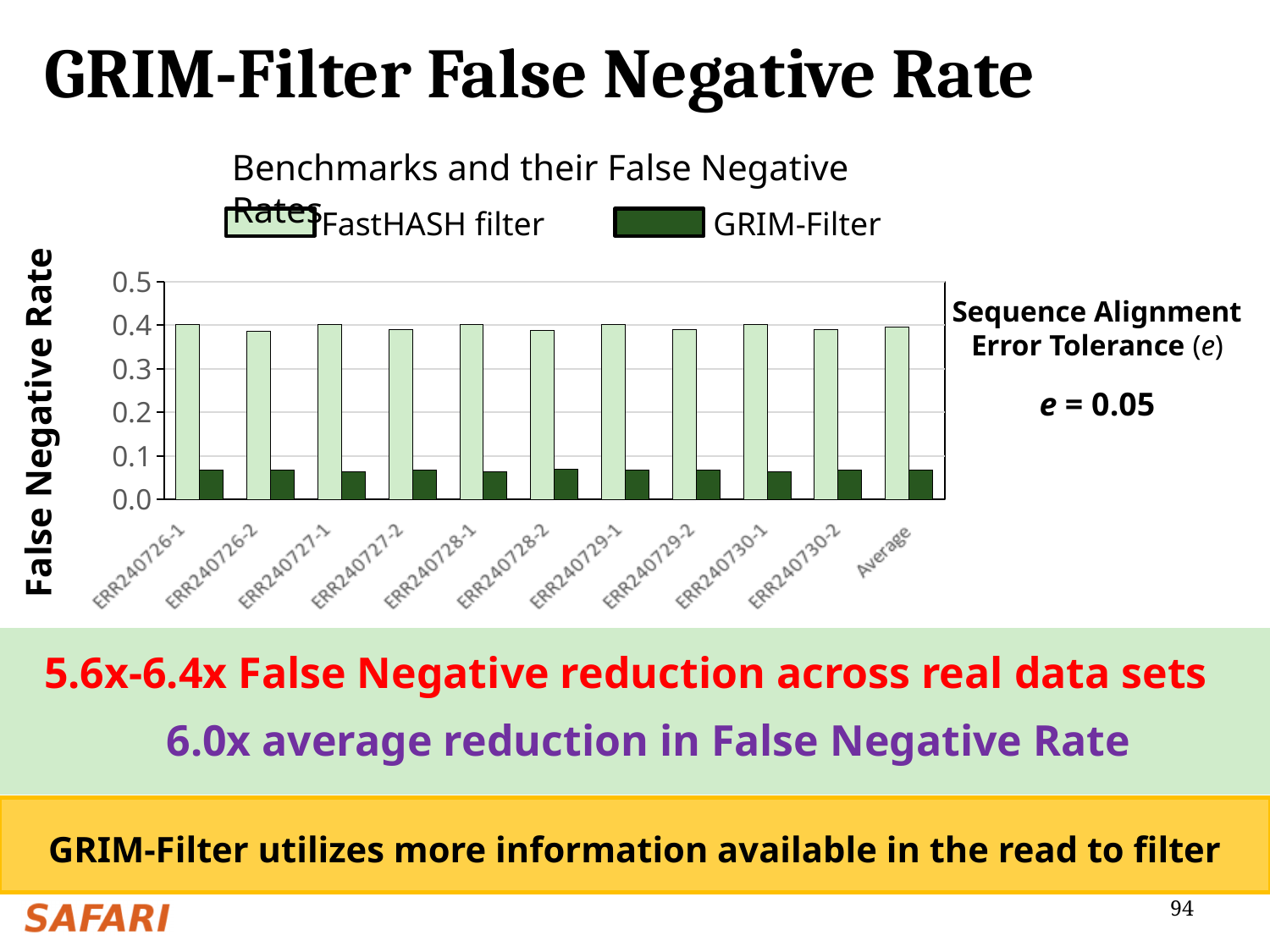
Which two series are listed in the chart legend? FastHASH filter and GRIM-Filter Is the GRIM-Filter value for ERR240726-1 greater or less than 0.1? less How many categories are shown along the x axis of the chart? 11 How many series does the chart legend list? 2 Is the FastHASH filter value for Average greater or less than 0.5? less For ERR240728-2, which series has the larger value, FastHASH filter or GRIM-Filter? FastHASH filter Is the FastHASH filter value for ERR240730-2 greater or less than 0.2? greater What is the label of the chart's y axis? False Negative Rate What kind of chart is shown on the slide? bar chart For Average, which series has the smaller value, FastHASH filter or GRIM-Filter? GRIM-Filter